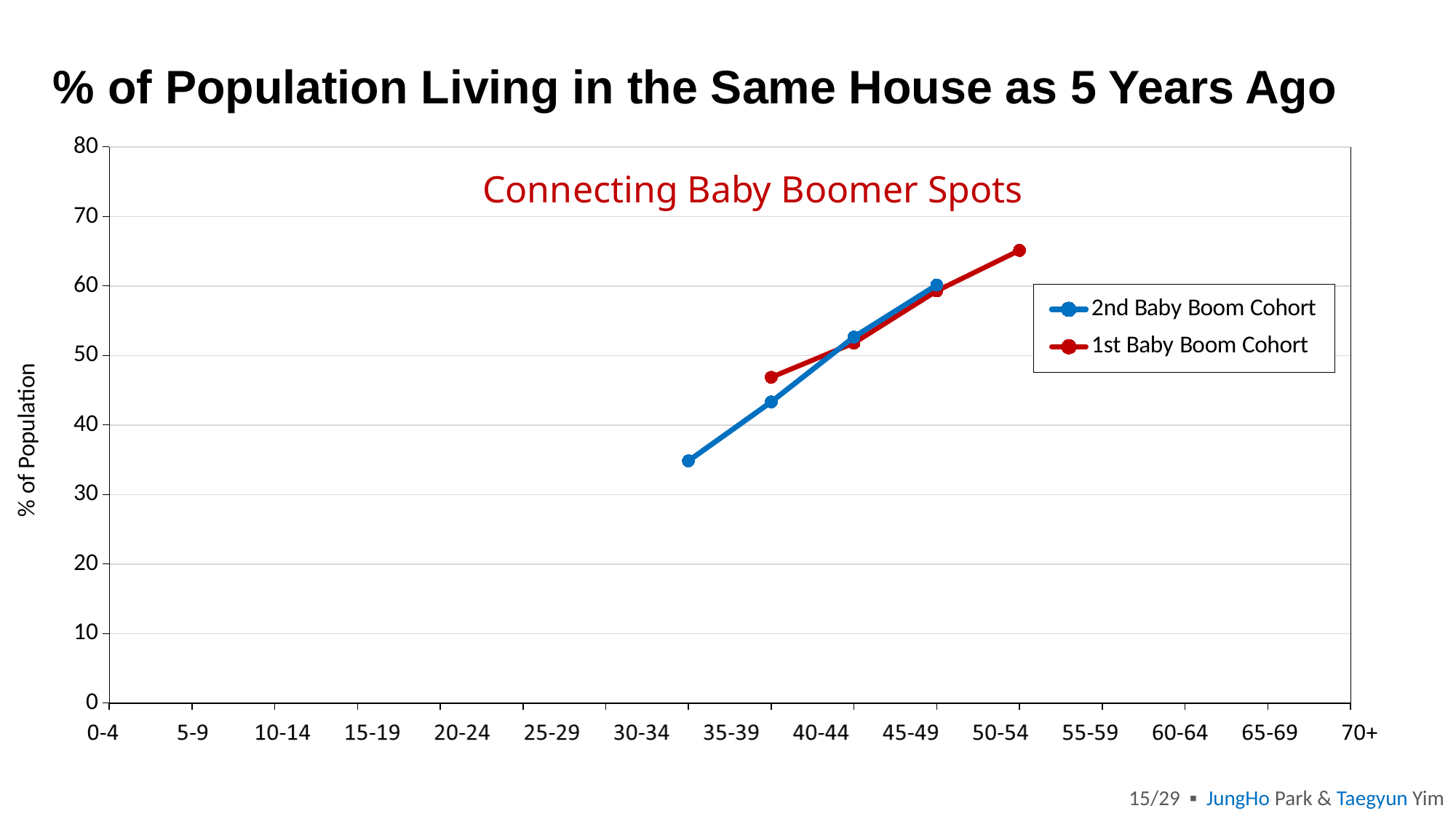
How many data points are plotted for the 1st Baby Boom Cohort series? 4 What is the label on the y axis? % of Population How many data points are plotted for the 2nd Baby Boom Cohort series? 4 Which series contains the lowest plotted point on the chart? 2nd Baby Boom Cohort Is the leftmost point of the 2nd Baby Boom Cohort line greater or less than 40? less Is the leftmost point of the 1st Baby Boom Cohort line greater or less than 50? less Do the values for the 2nd Baby Boom Cohort rise or fall as age increases along the x axis? rise What kind of chart is shown on the slide? line chart Which colour is used for the 1st Baby Boom Cohort line? red Which series reaches the highest value on the chart? 1st Baby Boom Cohort Is the rightmost (highest) point of the 1st Baby Boom Cohort line greater or less than 60? greater How many series does the legend list? 2